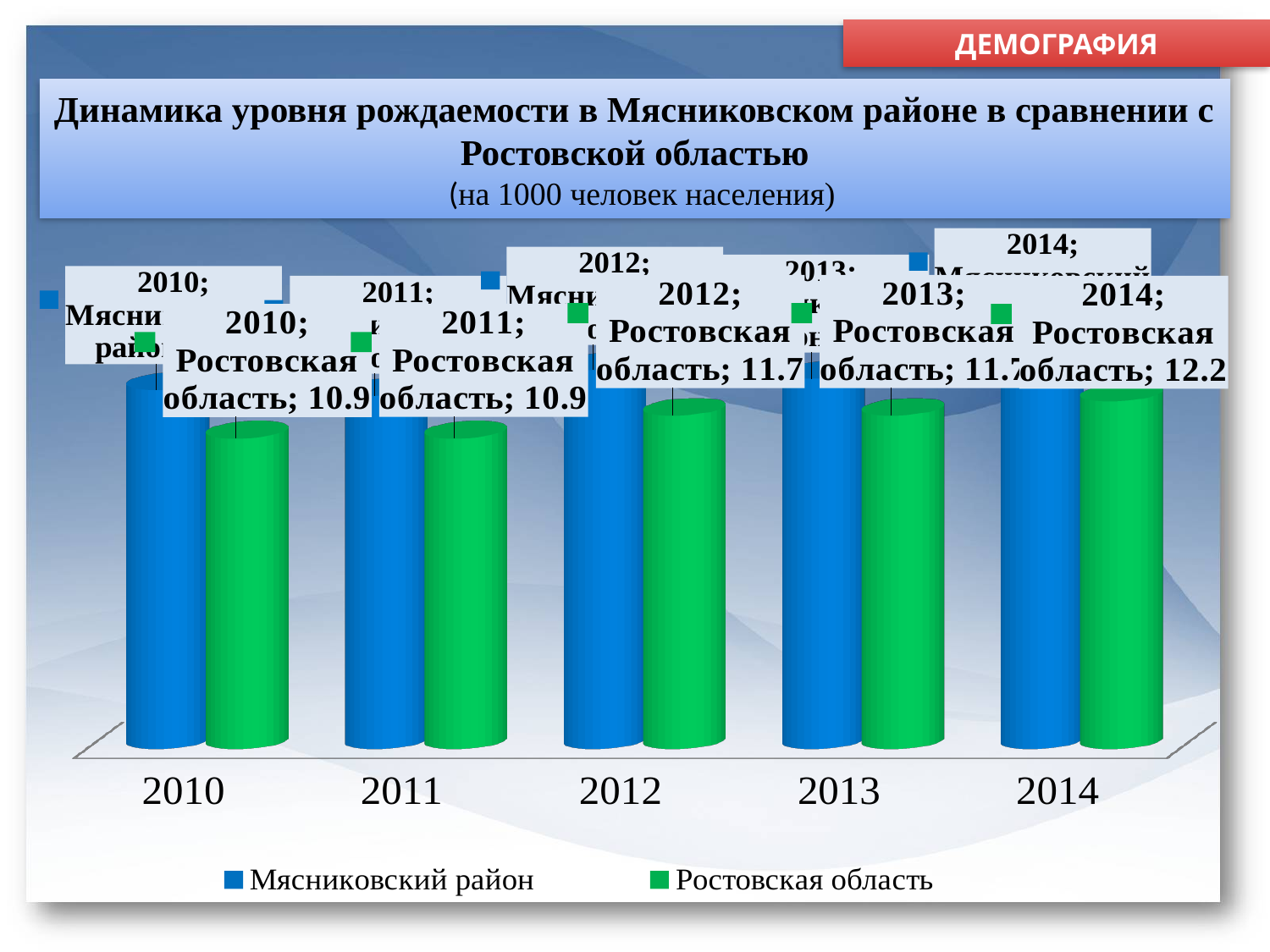
What is the value for Ростовская область in 2011? 10.9 What is the difference between the Ростовская область values for 2012 and 2011? 0.8 How many series does the legend list? 2 By how much did the value for Ростовская область increase from 2010 to 2014? 1.3 What is the value for Ростовская область in 2010? 10.9 Do the values for Ростовская область rise or fall from 2010 to 2014? rise What is the value for Ростовская область in 2012? 11.7 What is the value for Ростовская область in 2014? 12.2 How many years are shown on the x axis? 5 Which colour represents Ростовская область in the legend? green What kind of chart is shown on the slide? bar chart In 2010, which series has the taller bar, Мясниковский район or Ростовская область? Мясниковский район